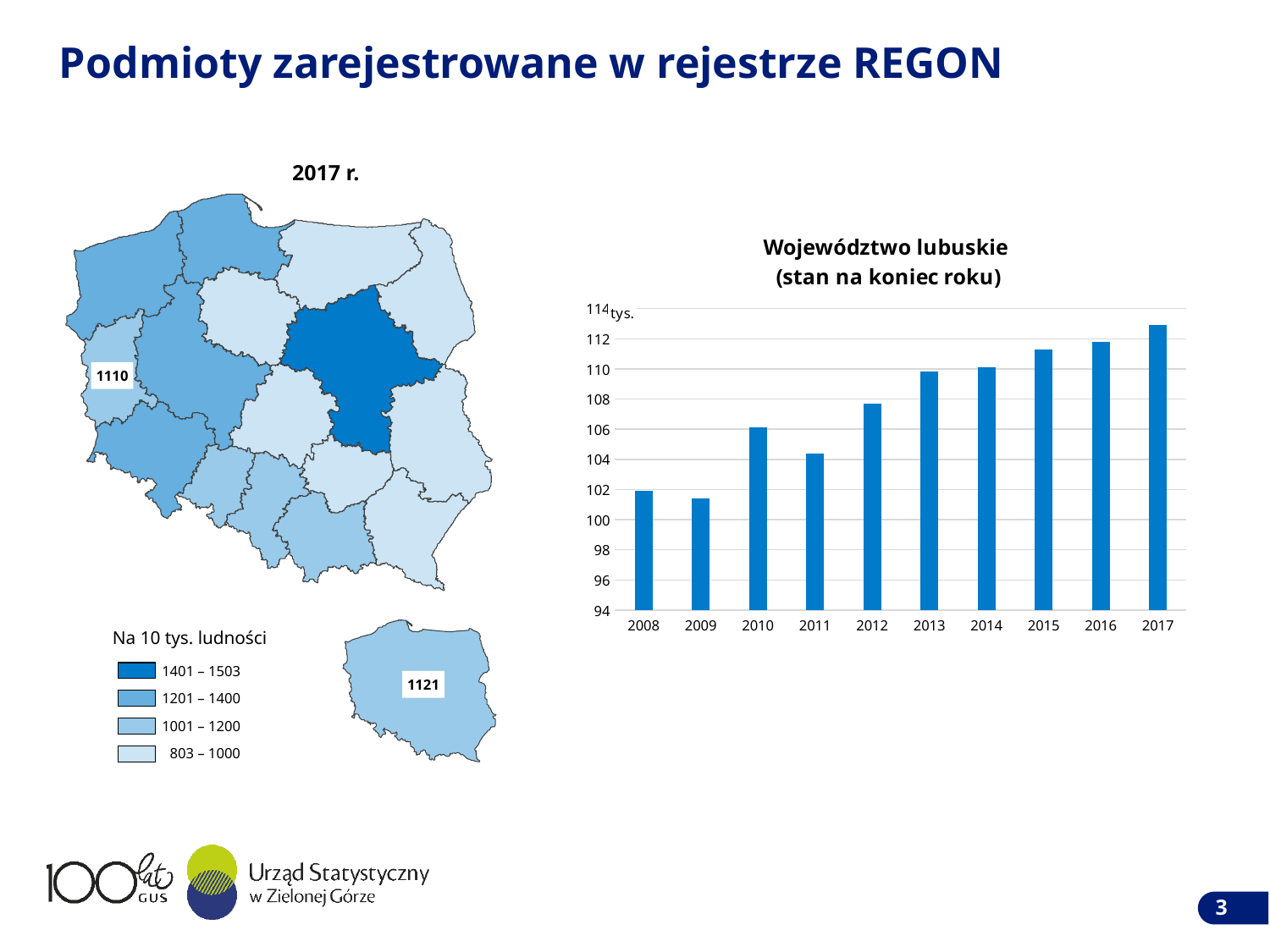
Which year has the highest bar in the bar chart? 2017 What kind of chart is shown on the right side of the slide? bar chart Is the value for 2015 in the bar chart greater or less than 110? greater Is the value for 2011 in the bar chart greater or less than 106? less What is the title of the bar chart? Województwo lubuskie (stan na koniec roku) Do the values in the bar chart generally rise or fall from 2008 to 2017? rise Is the value for 2017 in the bar chart greater or less than 112? greater How many years are shown on the x axis of the bar chart? 10 In the bar chart, which year has the larger value, 2012 or 2013? 2013 In the bar chart, which year has the larger value, 2010 or 2011? 2010